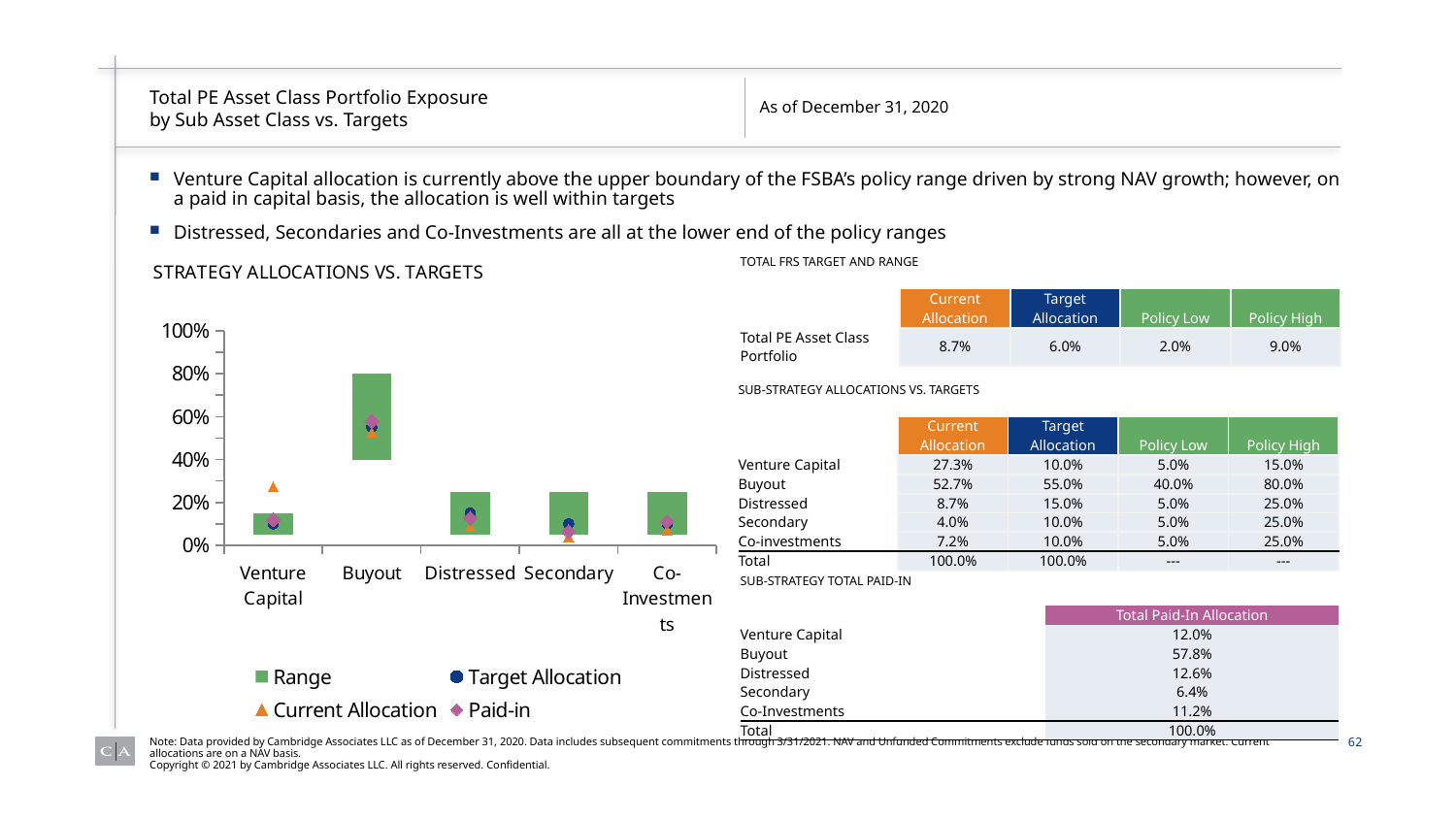
What colour are the Range bars in the chart? green In the chart, is the Current Allocation value for Secondary greater or less than 20%? less At what axis value does the bottom of the Buyout Range bar start in the chart? 40% How many sub asset class categories are shown on the x axis of the chart? 5 In the chart, which has the larger Current Allocation value, Buyout or Venture Capital? Buyout At what axis value does the top of the Buyout Range bar end in the chart? 80% In the chart, is the Current Allocation value for Venture Capital greater or less than 20%? greater Which category has the tallest Range bar in the chart? Buyout What kind of chart is shown under the heading STRATEGY ALLOCATIONS VS. TARGETS? bar chart How many series does the chart legend list? 4 In the chart, is the Target Allocation value for Buyout greater or less than 40%? greater